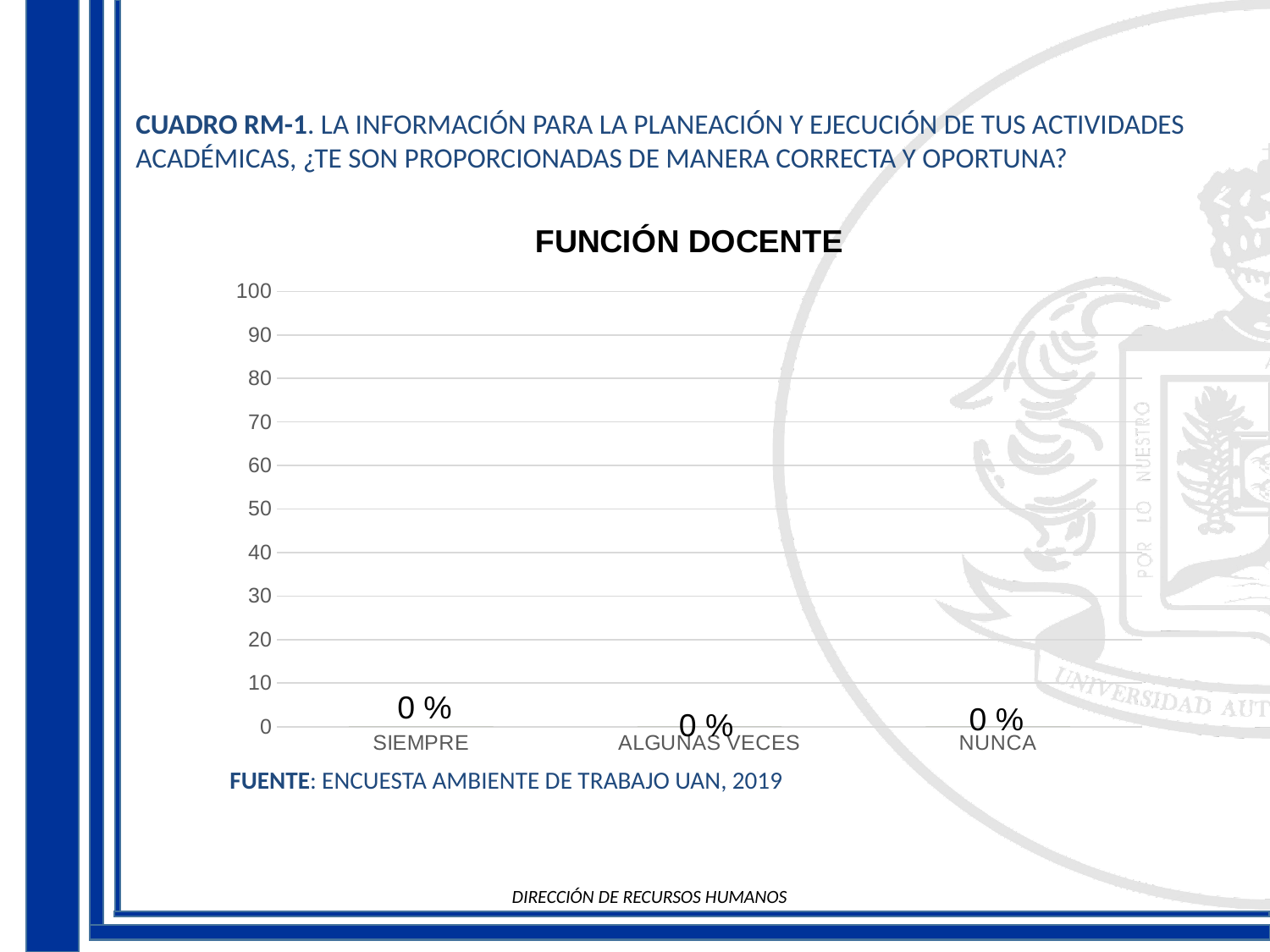
How many categories are shown on the x axis of the chart? 3 What is the difference between the values for SIEMPRE and NUNCA? 0 % What is the highest value shown on the vertical axis? 100 Is the value for ALGUNAS VECES greater or less than 50? less What is the value shown for SIEMPRE? 0 % Is the value for NUNCA greater or less than 10? less Do the values rise, fall, or stay the same from SIEMPRE to NUNCA? stay the same What is the value shown for ALGUNAS VECES? 0 % What is the value shown for NUNCA? 0 % What is the title of the chart? FUNCIÓN DOCENTE